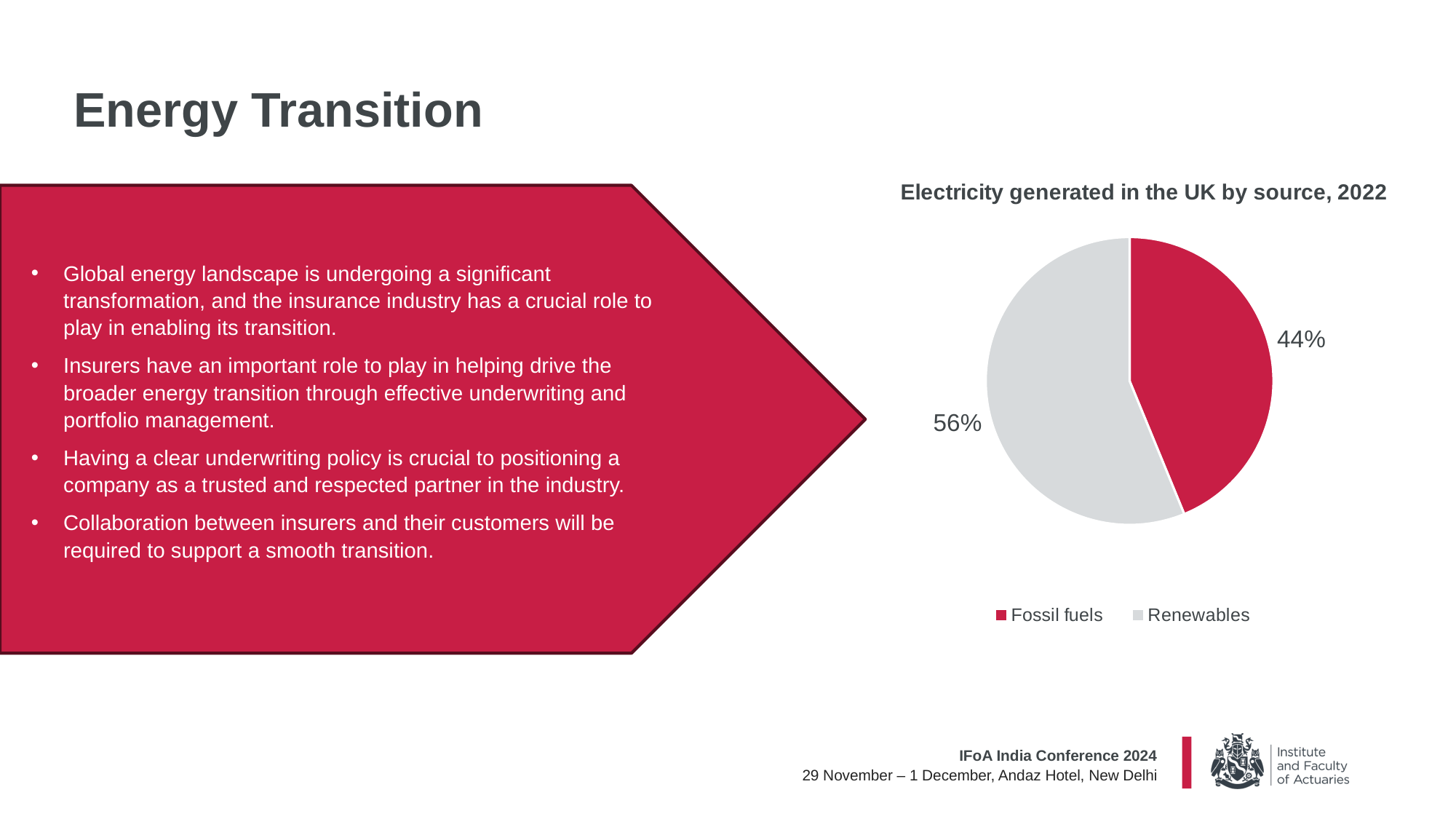
How many entries does the chart legend list? 2 Which source accounts for the largest share of the pie chart? Renewables How many categories does the pie chart show? 2 Which is larger in the pie chart: the fossil fuels share or the renewables share? Renewables What is the difference in percentage points between the renewables share and the fossil fuels share? 12 Which source accounts for the smallest share of the pie chart? Fossil fuels Is the fossil fuels share of the pie chart greater or less than 50%? less What is the title of the chart? Electricity generated in the UK by source, 2022 What share of UK electricity generated in 2022 came from fossil fuels? 44% Which colour represents fossil fuels in the pie chart? Red What kind of chart is shown on the slide? Pie chart What share of UK electricity generated in 2022 came from renewables? 56%